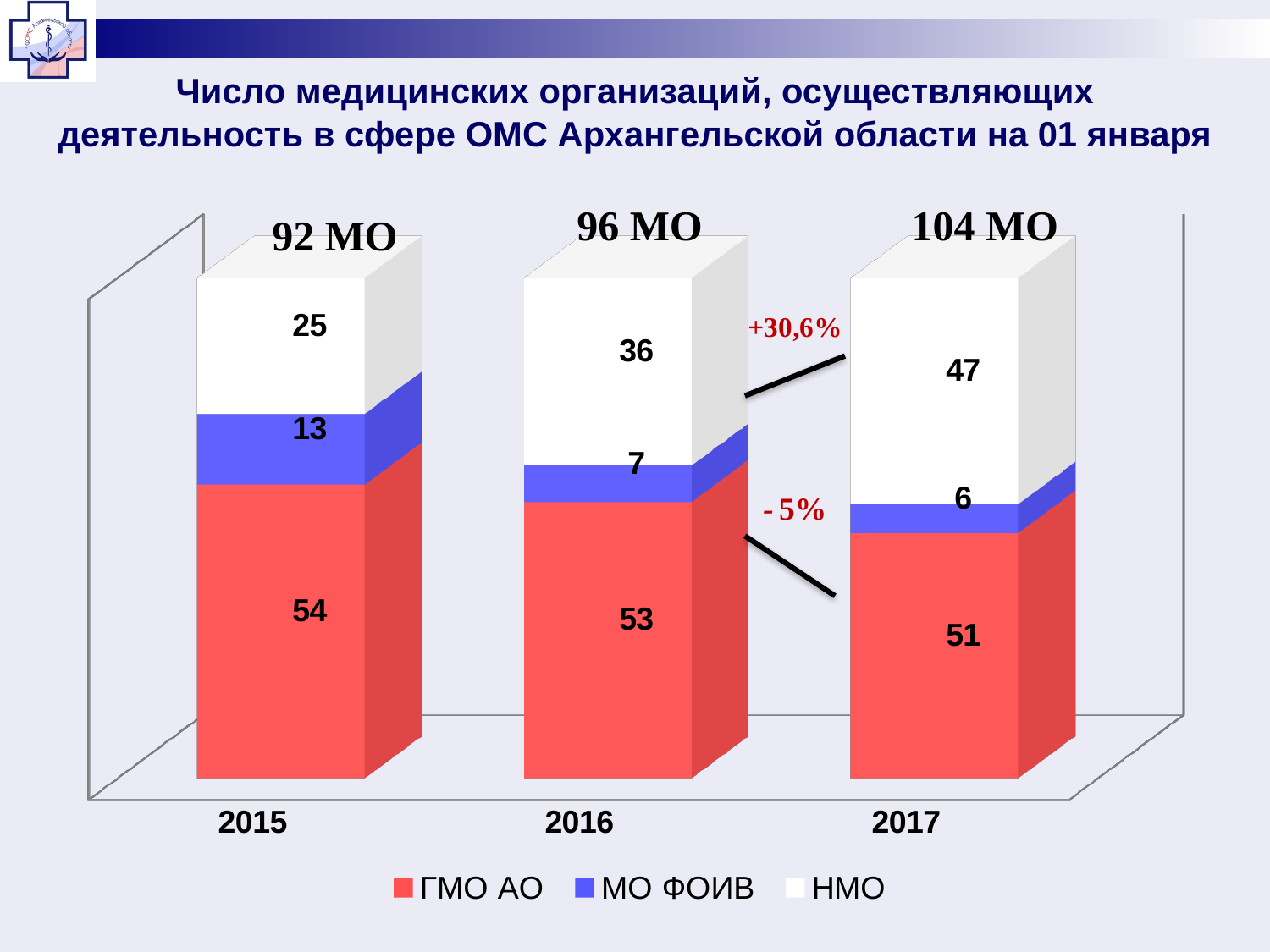
What is the total of the stacked bar for 2017? 104 What is the difference between the НМО values for 2017 and 2015? 22 What is the value for МО ФОИВ in 2016? 7 What is the value for НМО in 2017? 47 How many years are shown on the x axis? 3 What is the value for ГМО АО in 2015? 54 Which year has the highest value for НМО? 2017 Which year has the lowest value for МО ФОИВ? 2017 Which is larger, ГМО АО in 2015 or ГМО АО in 2017? ГМО АО in 2015 What kind of chart is shown on the slide? Stacked bar chart What is the total of the stacked bar for 2016? 96 How many series does the legend list? 3